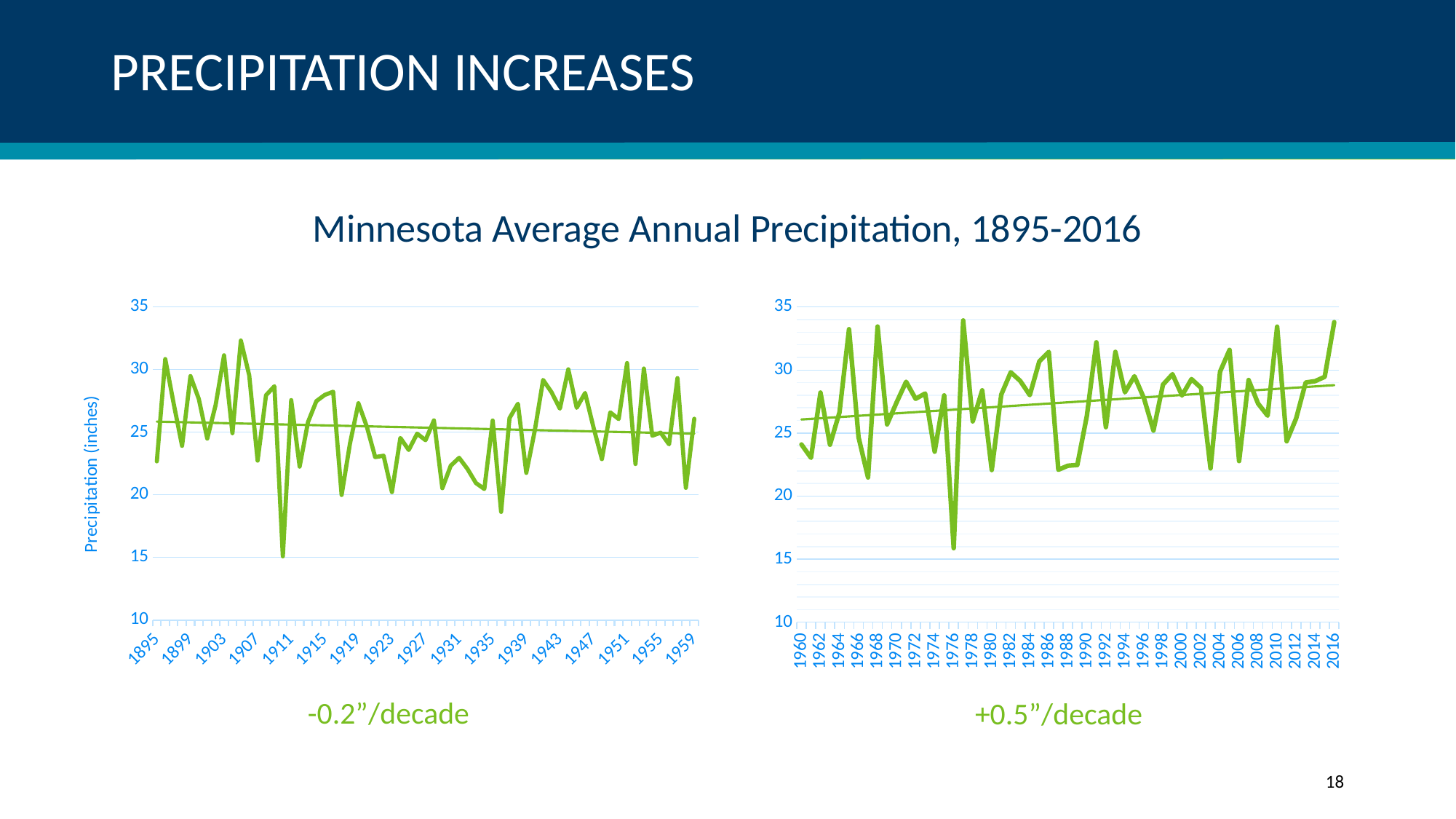
In the right chart (1960-2016), which year has the lowest precipitation? 1976 What is the y-axis label of the left chart? Precipitation (inches) In the right chart (1960-2016), is the value for 2016 greater or less than 30? greater What kind of chart is the right chart (1960-2016)? line chart What kind of chart is the left chart (1895-1959)? line chart In the left chart (1895-1959), which year has the lowest precipitation? 1910 In the left chart (1895-1959), does the trend line rise or fall from left to right? fall In the left chart (1895-1959), is the value for 1911 greater or less than 20? greater In the right chart (1960-2016), is the value for 1976 greater or less than 20? less What trend rate is printed below the right chart (1960-2016)? +0.5"/decade In the right chart (1960-2016), does the trend line rise or fall from left to right? rise